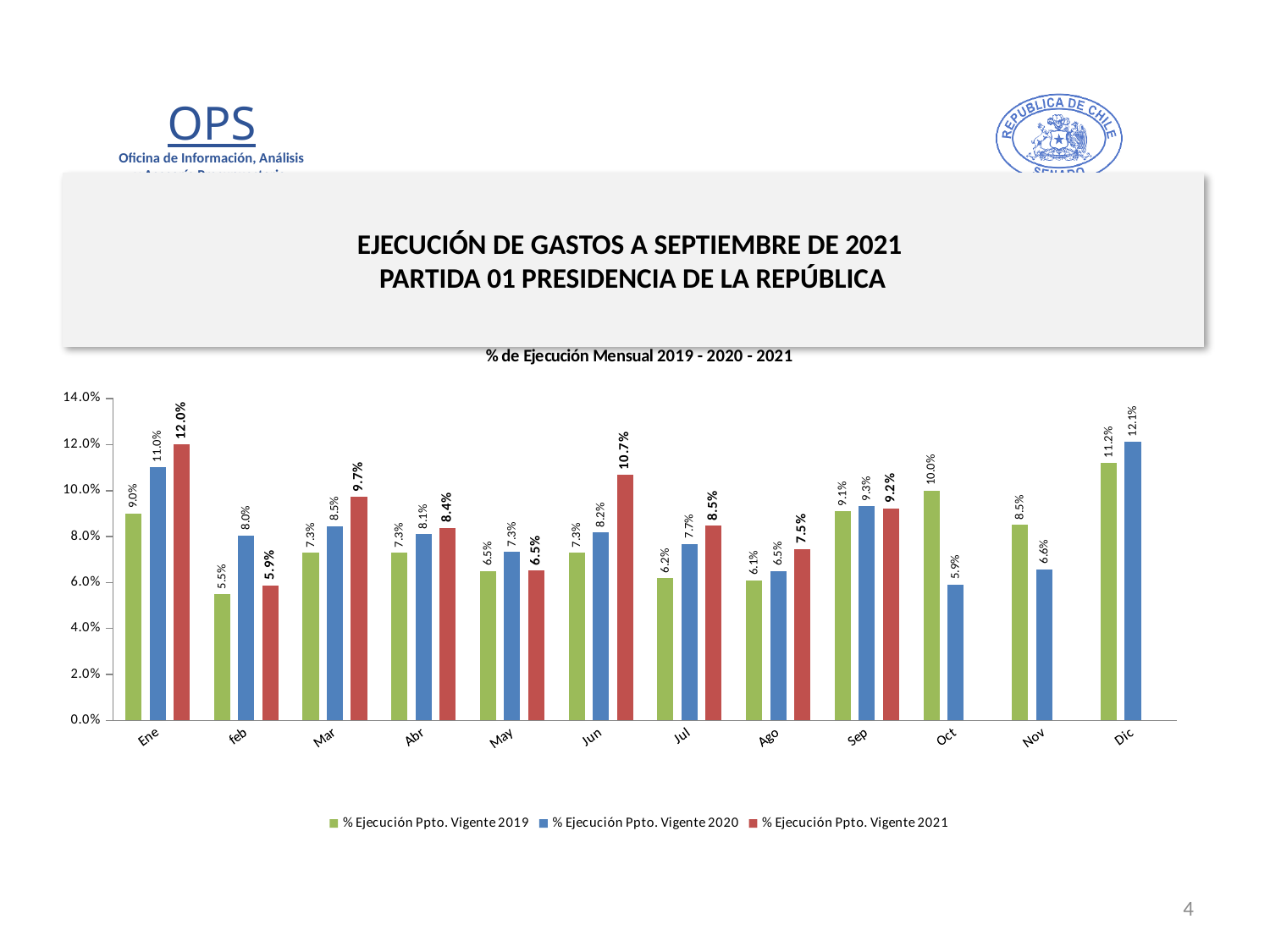
How many series does the legend list? 3 Which month has the lowest value for % Ejecución Ppto. Vigente 2019? feb What is the title of the chart? % de Ejecución Mensual 2019 - 2020 - 2021 In Oct, which is larger: the 2019 value or the 2020 value? 2019 Which month has the highest value for % Ejecución Ppto. Vigente 2021? Ene What is the value for % Ejecución Ppto. Vigente 2021 in Ene? 12.0% What is the value for % Ejecución Ppto. Vigente 2020 in Dic? 12.1% Is the value for % Ejecución Ppto. Vigente 2020 in Ene greater or less than 10.0%? greater What kind of chart is shown on the slide? Bar chart What is the value for % Ejecución Ppto. Vigente 2019 in Oct? 10.0% What is the difference between the 2021 and 2019 values in Jun? 3.4% How many months are shown on the x axis? 12